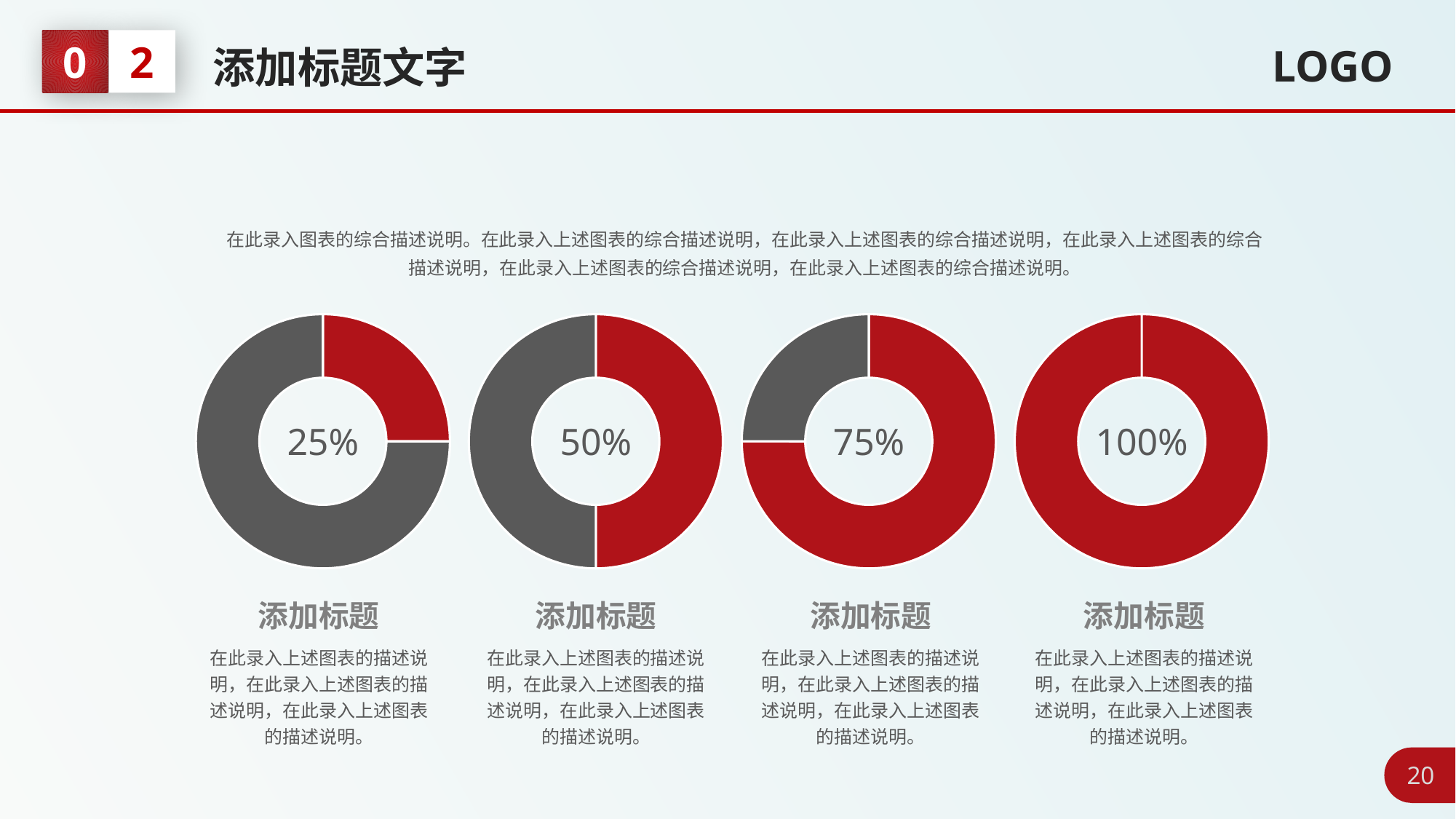
Which is larger, the value in the second donut chart from the left or the value in the third donut chart from the left? The third donut chart (75%) Do the percentages in the donut charts increase or decrease from left to right across the slide? Increase Which donut chart shows the lowest percentage? The leftmost one (25%) What value is shown in the centre of the second donut chart from the left? 50% Which donut chart shows the highest percentage? The rightmost one (100%) What value is shown in the centre of the third donut chart from the left? 75% What kind of chart is used for each of the four figures on the slide? Donut chart What is the difference between the value in the rightmost donut chart and the value in the leftmost donut chart? 75% How many donut charts are on the slide? 4 What value is shown in the centre of the rightmost donut chart? 100% What colour is used for the filled (percentage) portion of each donut chart? Red What value is shown in the centre of the leftmost donut chart? 25%